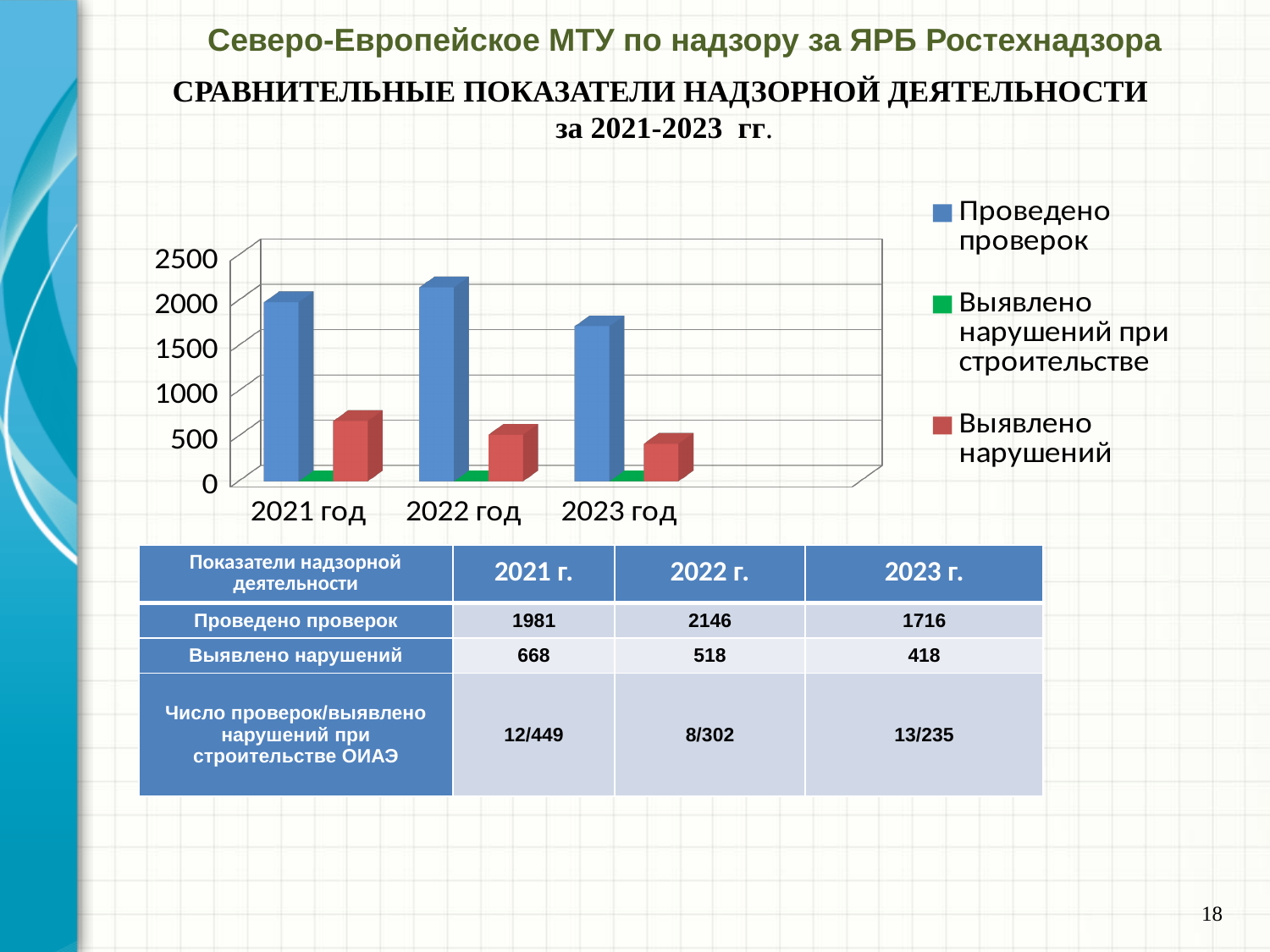
How many year categories are shown on the x axis of the chart? 3 How many series does the chart legend list? 3 Do the values for Выявлено нарушений rise or fall from 2021 год to 2023 год? fall What colour are the bars for Проведено проверок in the chart? blue Which is larger: Выявлено нарушений in 2021 год or in 2023 год? 2021 год What kind of chart is shown on the slide? bar chart In which year is the value for Проведено проверок highest? 2022 год In which year is the value for Проведено проверок lowest? 2023 год According to the table on the slide, what is the value of Проведено проверок for 2022? 2146 Is the value for Проведено проверок in 2023 год greater or less than 2000? less Is the value for Выявлено нарушений in 2021 год greater or less than 500? greater Is the value for Проведено проверок in 2021 год greater or less than 1500? greater